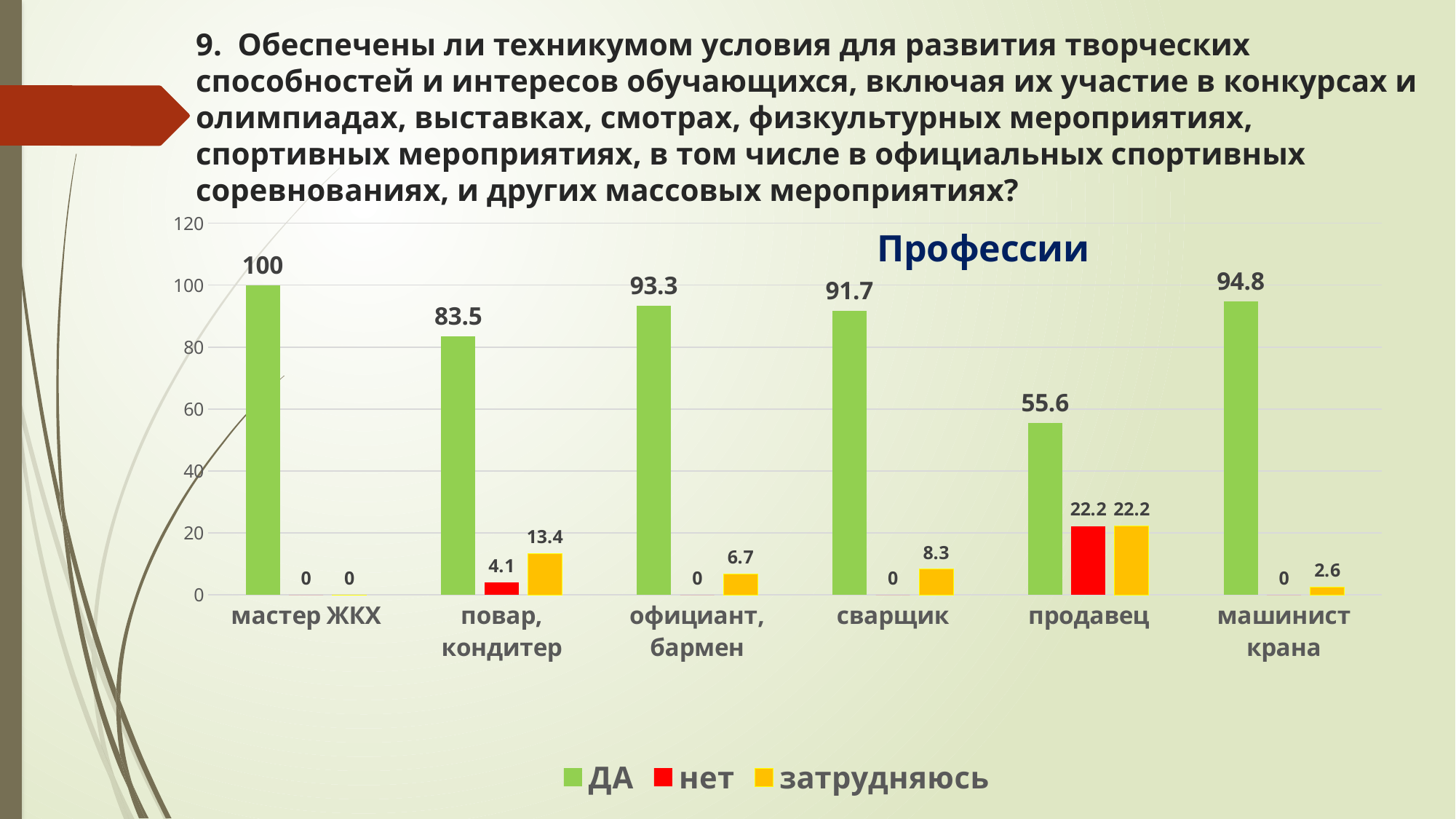
Which is larger: the ДА value for повар, кондитер or the ДА value for сварщик? сварщик What is the value of the затрудняюсь series for повар, кондитер? 13.4 What is the value of the ДА series for машинист крана? 94.8 What kind of chart is shown on the slide? bar chart How many series does the legend list? 3 What is the value of the нет series for продавец? 22.2 What is the title of the chart? Профессии Which category has the lowest value in the ДА series? продавец How many categories are shown on the x axis? 6 Which category has the highest value in the ДА series? мастер ЖКХ What is the value of the ДА series for мастер ЖКХ? 100 What is the difference between the ДА values for официант, бармен and сварщик? 1.6